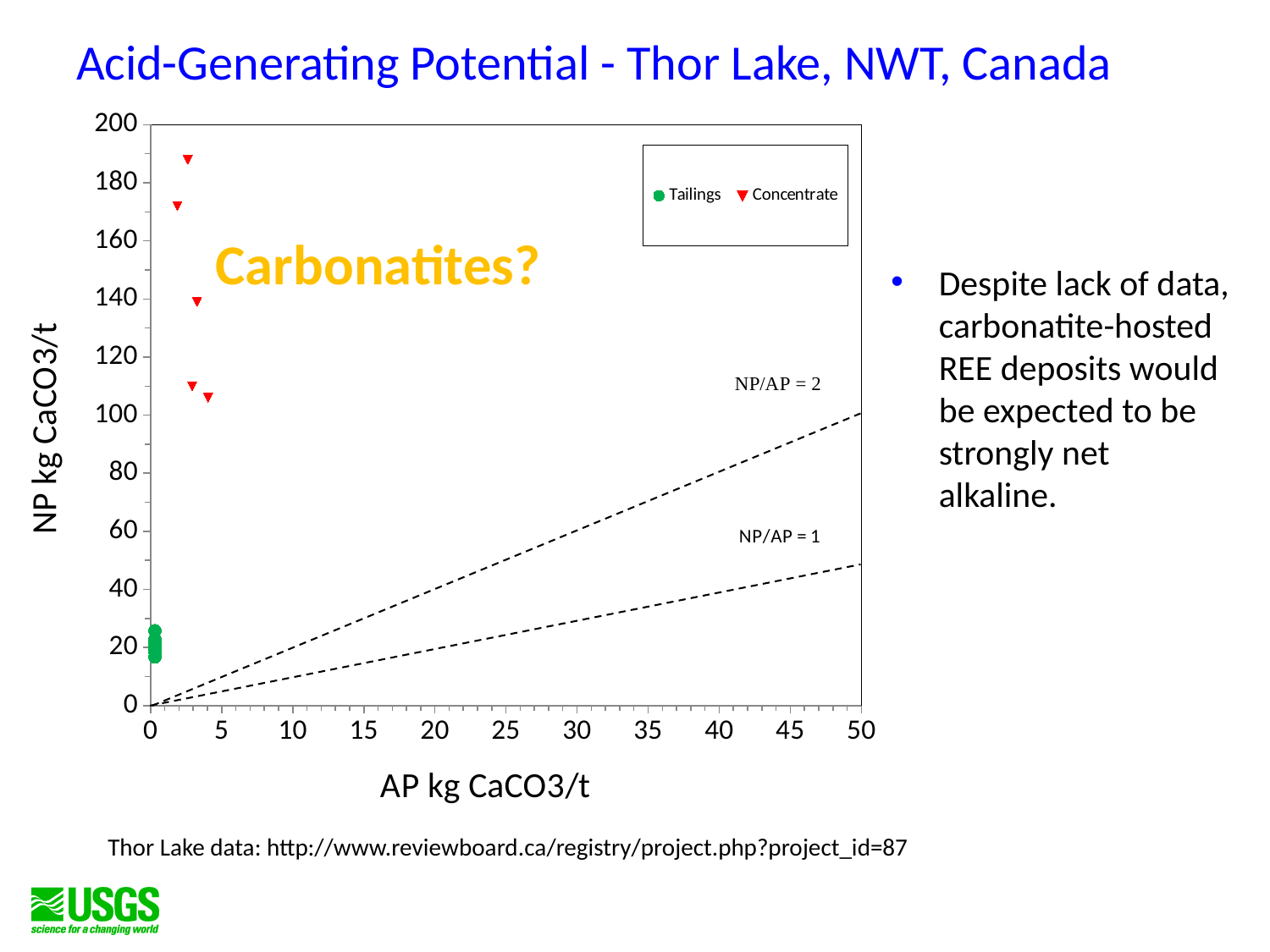
Are the AP values of the Tailings points greater or less than 5? less Are the NP values of the Tailings points greater or less than 40? less What are the two series named in the legend? Tailings and Concentrate How many series does the legend list? 2 Is the NP value of the lowest Concentrate point greater or less than 100? greater What is the title of the chart? Acid-Generating Potential - Thor Lake, NWT, Canada What kind of chart is shown on the slide? Scatter chart Which series has the lowest NP values on the chart? Tailings How many Concentrate points are plotted on the chart? 5 Which series has the higher NP values, Tailings or Concentrate? Concentrate What is the maximum value shown on the x axis (AP kg CaCO3/t)? 50